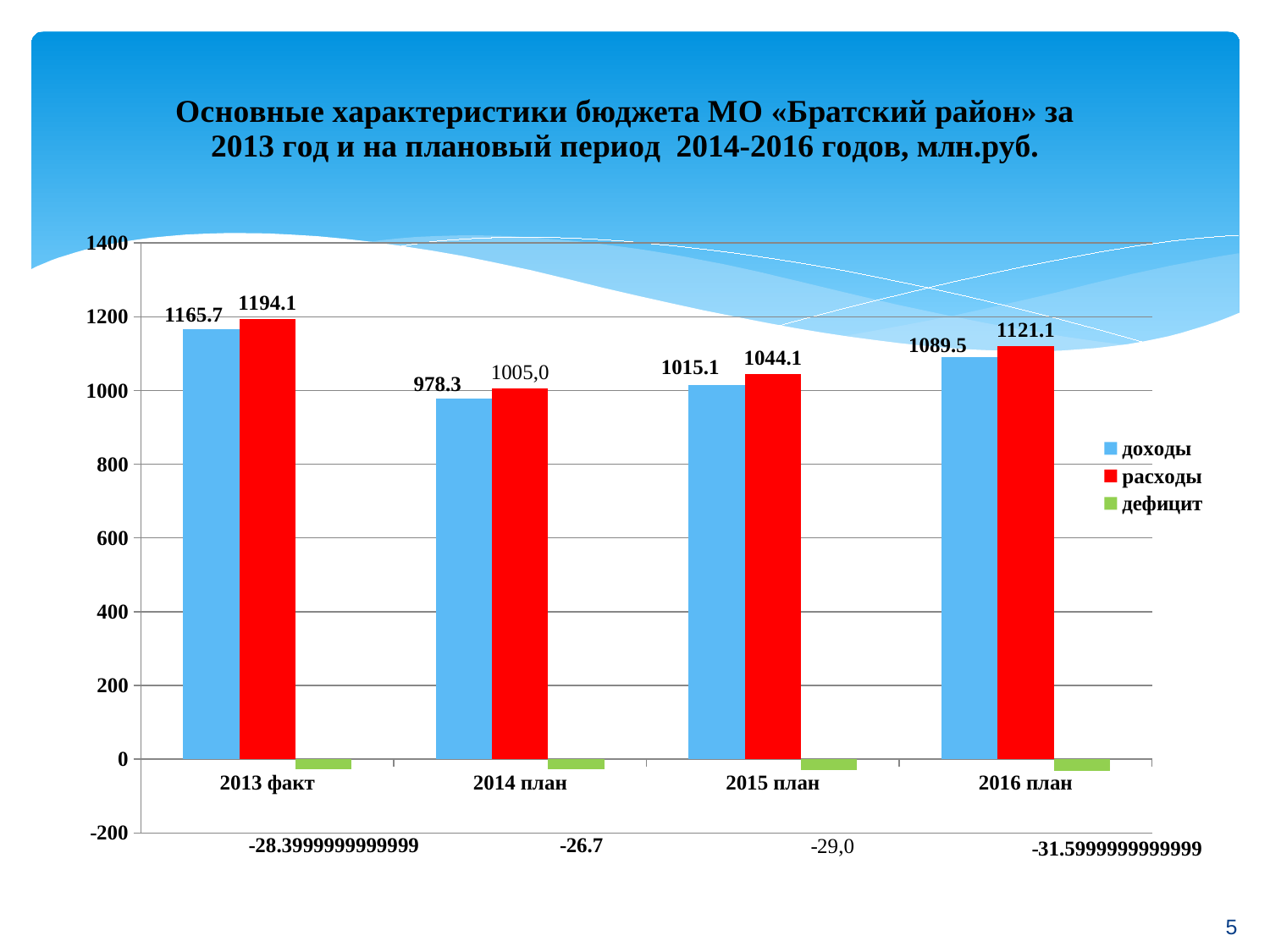
Do the values of доходы rise or fall from 2014 план to 2016 план? rise Which category has the highest value of доходы? 2013 факт How many categories are shown on the x axis? 4 What is the value of расходы for 2014 план? 1005,0 What is the value of доходы for 2013 факт? 1165.7 Is the value of доходы for 2014 план greater or less than 1000? less How many series does the legend list? 3 What is the value of расходы for 2016 план? 1121.1 Which category has the lowest value of расходы? 2014 план What is the value of дефицит for 2015 план? -29,0 Which is larger for 2016 план: доходы or расходы? расходы What is the difference between расходы and доходы for 2015 план? 29.0